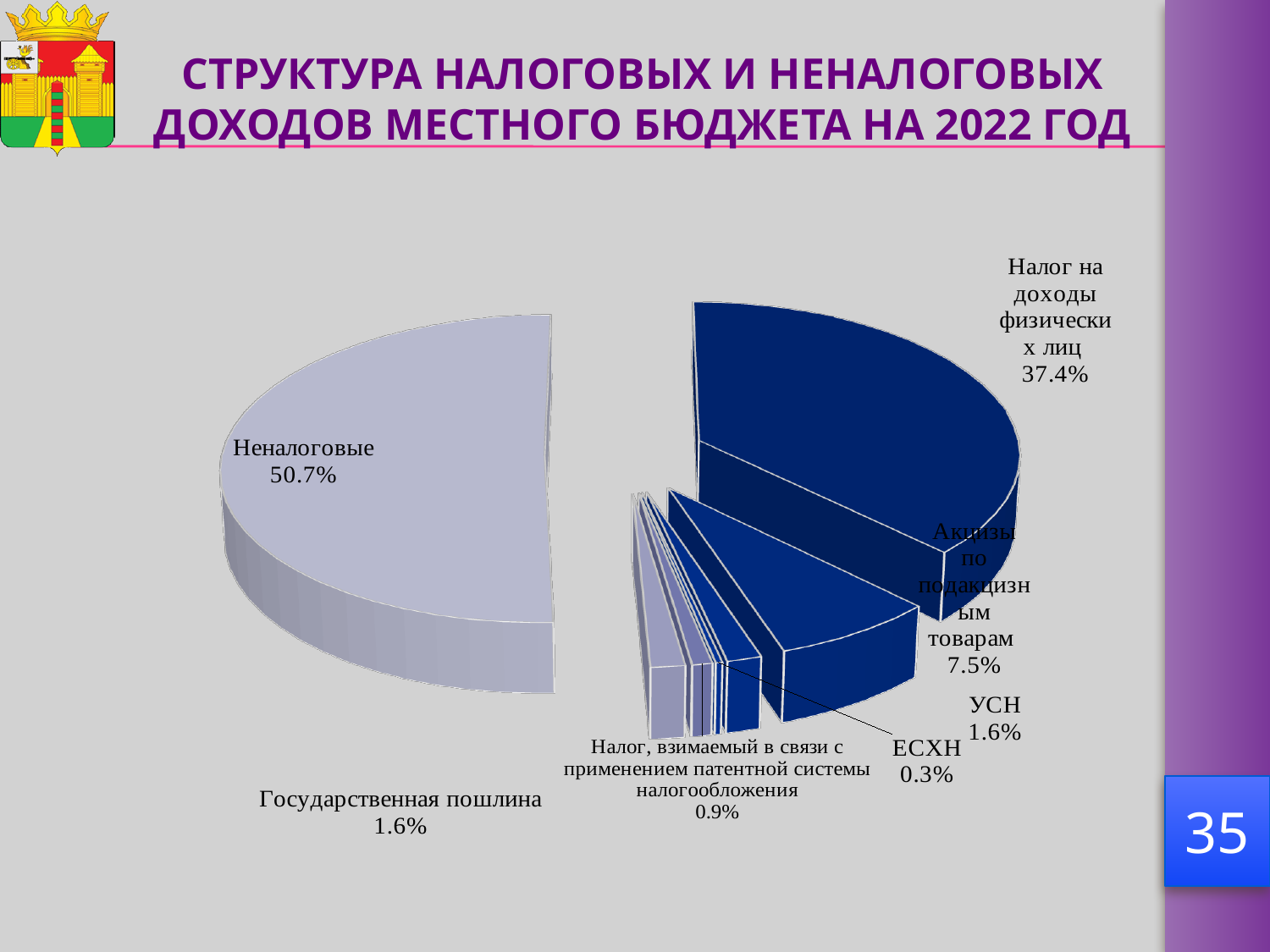
What percentage is shown for Акцизы по подакцизным товарам? 7.5% Which category has the largest slice of the pie? Неналоговые What is the value labelled for ЕСХН? 0.3% What share of the pie does Неналоговые hold? 50.7% Which category has the smallest slice of the pie? ЕСХН How many slices does the pie chart have? 7 What type of chart is shown on the slide? Pie chart Which is larger: the share for Акцизы по подакцизным товарам or the share for УСН? Акцизы по подакцизным товарам What is the value shown for Налог на доходы физических лиц? 37.4% What is the difference between the shares of Неналоговые and Налог на доходы физических лиц? 13.3% What share is shown for Налог, взимаемый в связи с применением патентной системы налогообложения? 0.9% What is the title of the slide containing the chart? СТРУКТУРА НАЛОГОВЫХ И НЕНАЛОГОВЫХ ДОХОДОВ МЕСТНОГО БЮДЖЕТА НА 2022 ГОД